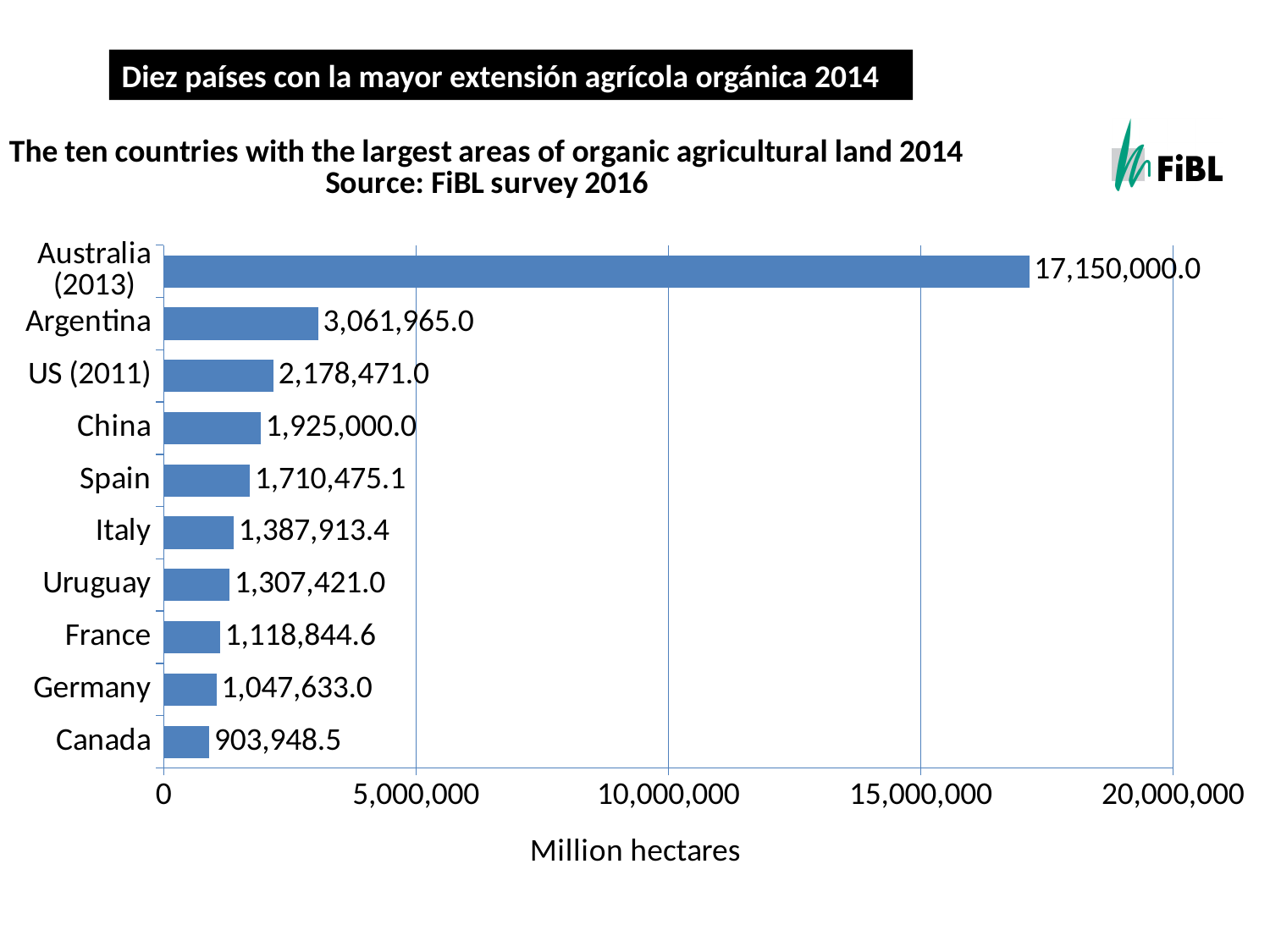
Is the value for Australia (2013) greater or less than 15,000,000? greater What kind of chart is shown on the slide? bar chart Which country has the smallest value on the chart? Canada What is the value for Australia (2013)? 17,150,000.0 What is the value for Canada? 903,948.5 How many countries are shown on the chart? 10 What is the difference between the values for Argentina and US (2011)? 883,494.0 What is the value for Argentina? 3,061,965.0 Which country has the largest area of organic agricultural land? Australia (2013) What is the value for Spain? 1,710,475.1 What is the difference between the values for Germany and Canada? 143,684.5 Which has a larger value, China or Spain? China